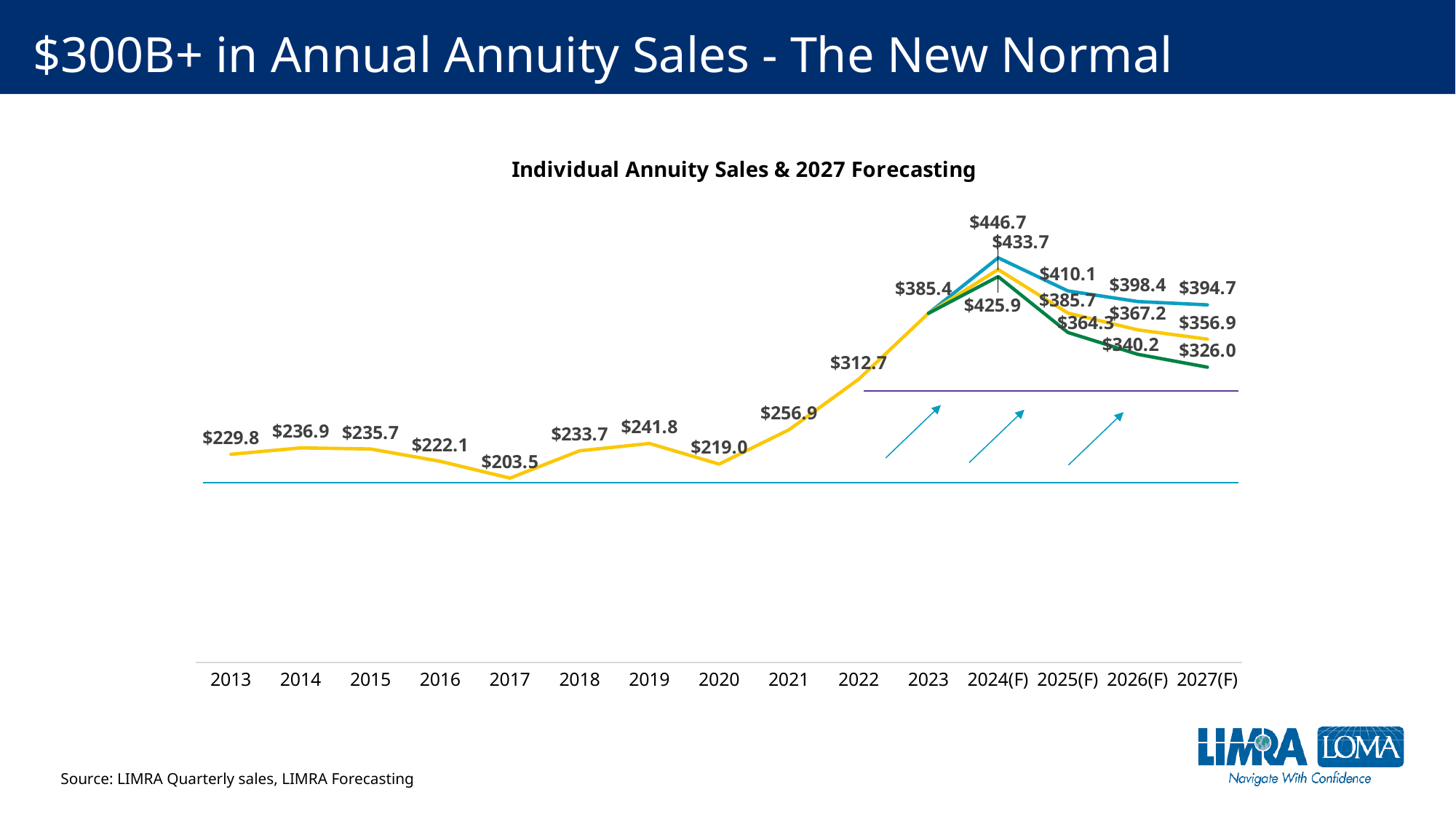
Do the values rise or fall from 2020 to 2023? rise What is the difference between the 2023 value and the 2022 value? $72.7 What is the title of the chart? Individual Annuity Sales & 2027 Forecasting Which year between 2013 and 2023 has the lowest value? 2017 Which year between 2013 and 2023 has the highest value? 2023 What is the value for 2021? $256.9 What is the highest forecast value labelled for 2027(F)? $394.7 What is the value for 2023? $385.4 What type of chart is shown on the slide? line chart Which is larger, the value for 2019 or the value for 2020? 2019 How many years are shown on the x axis? 15 What is the value for 2013? $229.8